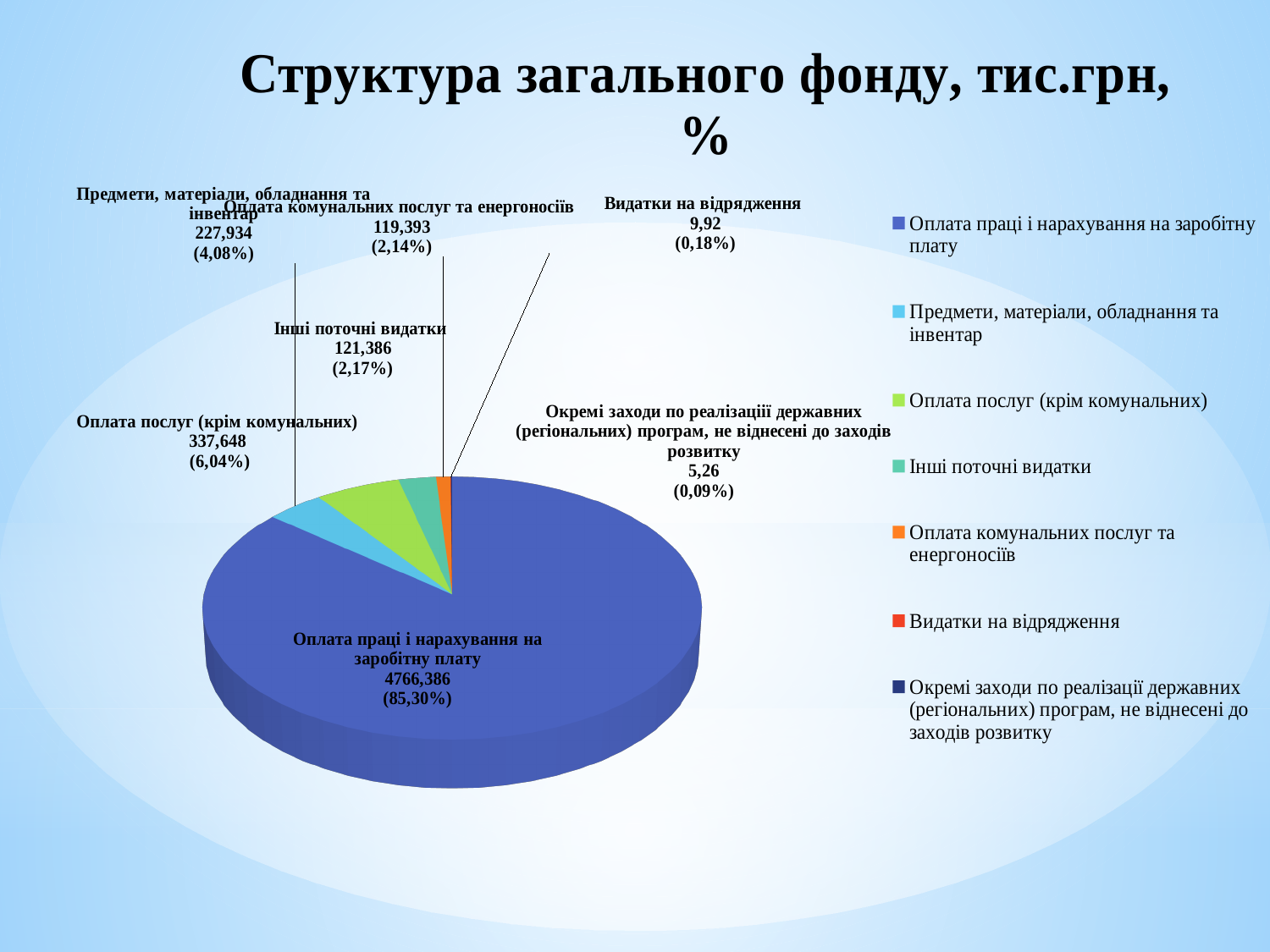
What is the difference between the values for Оплата послуг (крім комунальних) and Предмети, матеріали, обладнання та інвентар? 109,714 What is the title of the chart? Структура загального фонду, тис.грн, % Which category has the smallest slice of the pie? Окремі заходи по реалізації державних (регіональних) програм, не віднесені до заходів розвитку What is the value for Видатки на відрядження? 9,92 What share of the pie does Оплата праці і нарахування на заробітну плату represent? 85,30% How many categories does the legend list? 7 What is the value for Оплата послуг (крім комунальних)? 337,648 Which category has the largest slice of the pie? Оплата праці і нарахування на заробітну плату What share of the pie does Предмети, матеріали, обладнання та інвентар represent? 4,08% What is the value for Оплата праці і нарахування на заробітну плату? 4766,386 Which is larger: Оплата послуг (крім комунальних) or Предмети, матеріали, обладнання та інвентар? Оплата послуг (крім комунальних) What kind of chart is shown on the slide? Pie chart